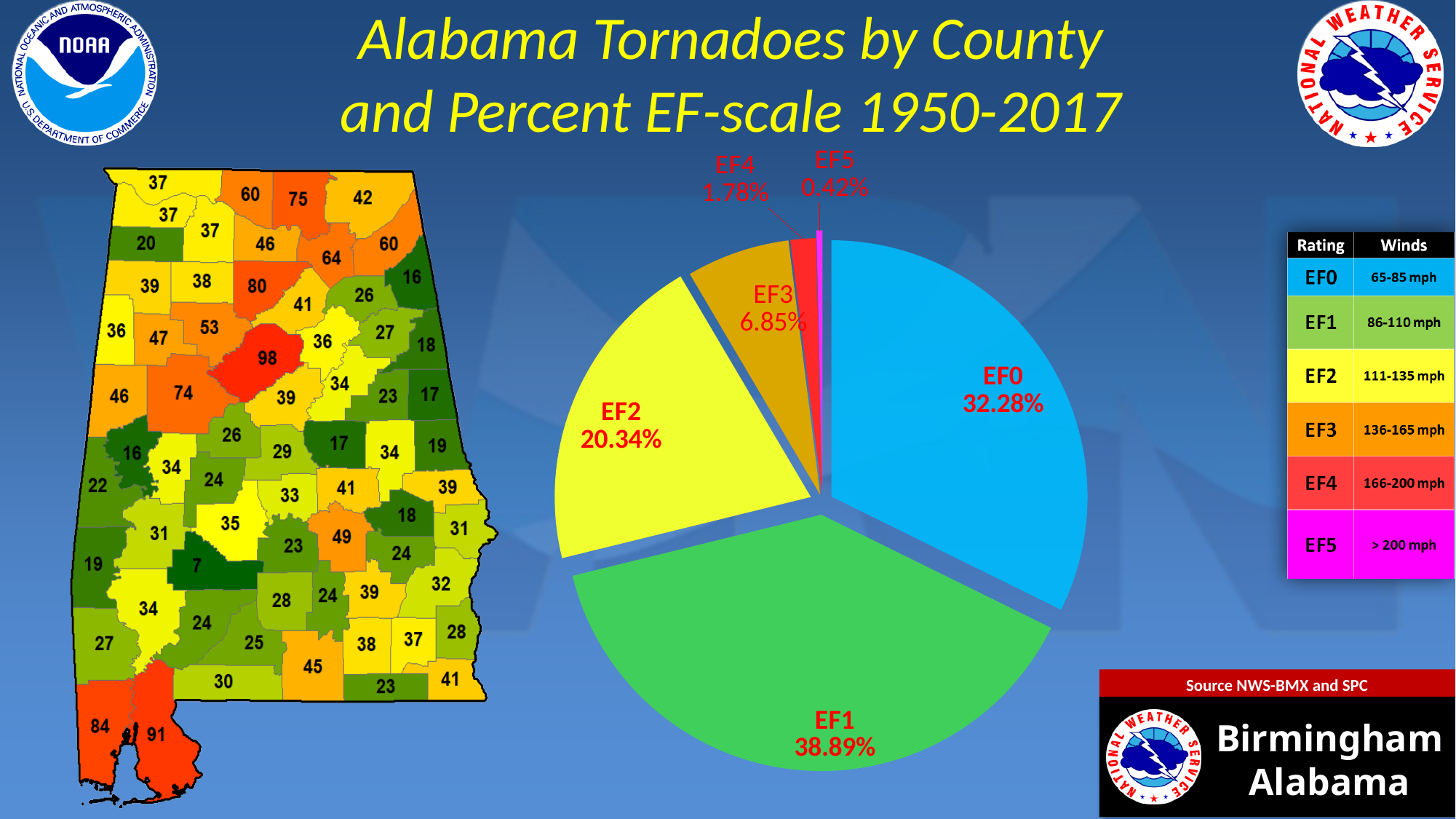
Which EF rating has the largest slice in the pie chart? EF1 What colour is the EF0 slice in the pie chart? light blue In the pie chart, what percentage of tornadoes were rated EF1? 38.89% In the pie chart, what is the difference in percentage points between EF1 and EF0? 6.61 Which EF rating has the smallest slice in the pie chart? EF5 In the pie chart, what percentage of tornadoes were rated EF3? 6.85% In the pie chart, which is larger, the EF0 slice or the EF2 slice? EF0 In the pie chart, what percentage of tornadoes were rated EF0? 32.28% How many EF rating slices does the pie chart have? 6 According to the legend table, what wind range corresponds to EF3? 136-165 mph What kind of chart shows the percent EF-scale breakdown on the slide? pie chart In the pie chart, what percentage of tornadoes were rated EF5? 0.42%